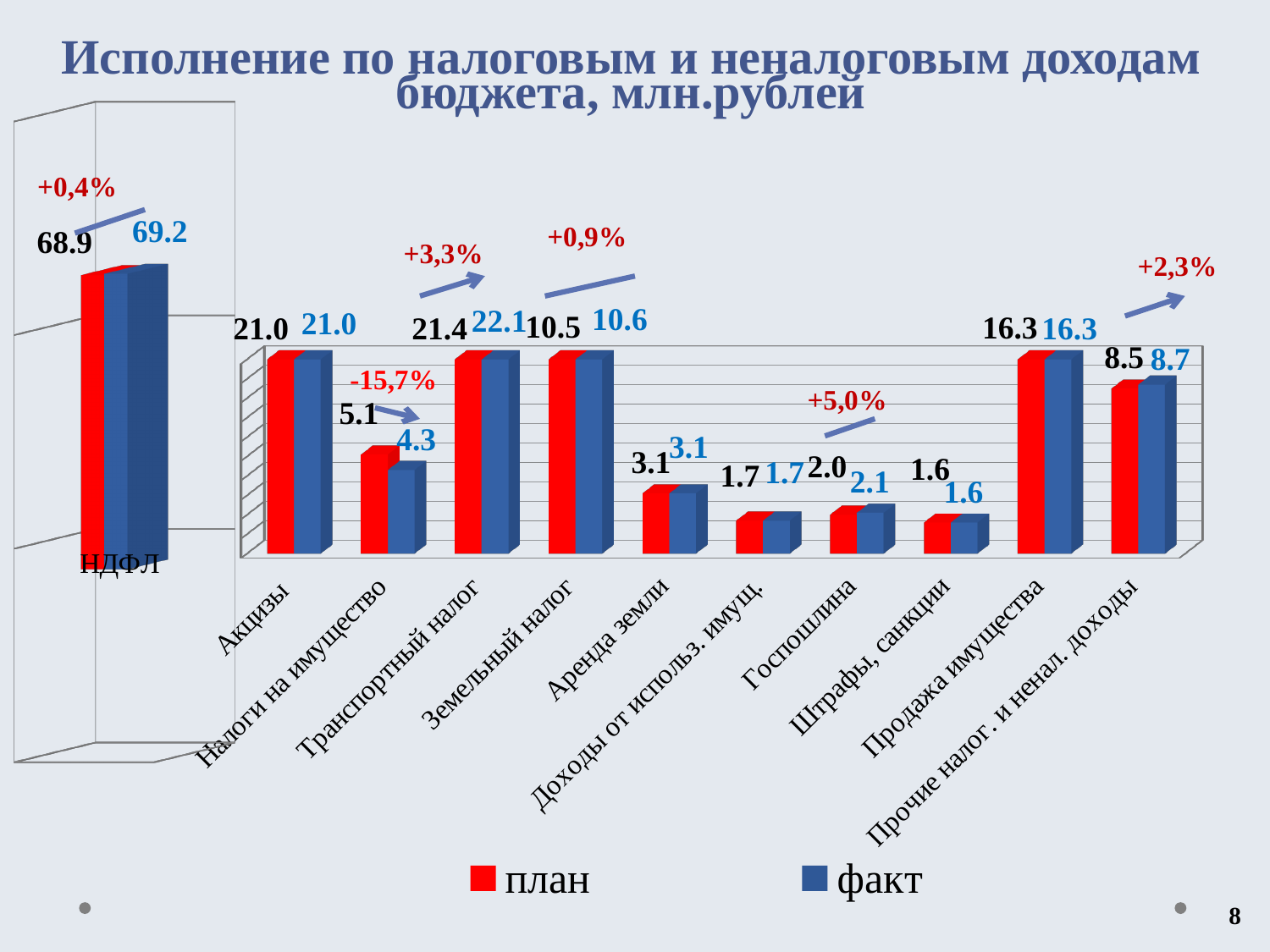
What kind of chart is the main chart on the right? bar chart In the main chart on the right, what is the difference between the план and факт values for Налоги на имущество? 0.8 How many series does the legend list? 2 How many categories are shown in the main chart on the right? 10 What percentage change is annotated above the Транспортный налог bars in the main chart? +3,3% In the main chart on the right, which category has the lowest план value? Штрафы, санкции In the small chart on the left, is the план value for НДФЛ greater or less than 60? greater In the small chart on the left, what is the факт value for НДФЛ? 69.2 In the main chart on the right, what is the факт value for Налоги на имущество? 4.3 In the main chart on the right, which is larger for Госпошлина: план or факт? факт In the main chart on the right, what is the план value for Транспортный налог? 21.4 In the main chart on the right, which category has the highest факт value? Транспортный налог